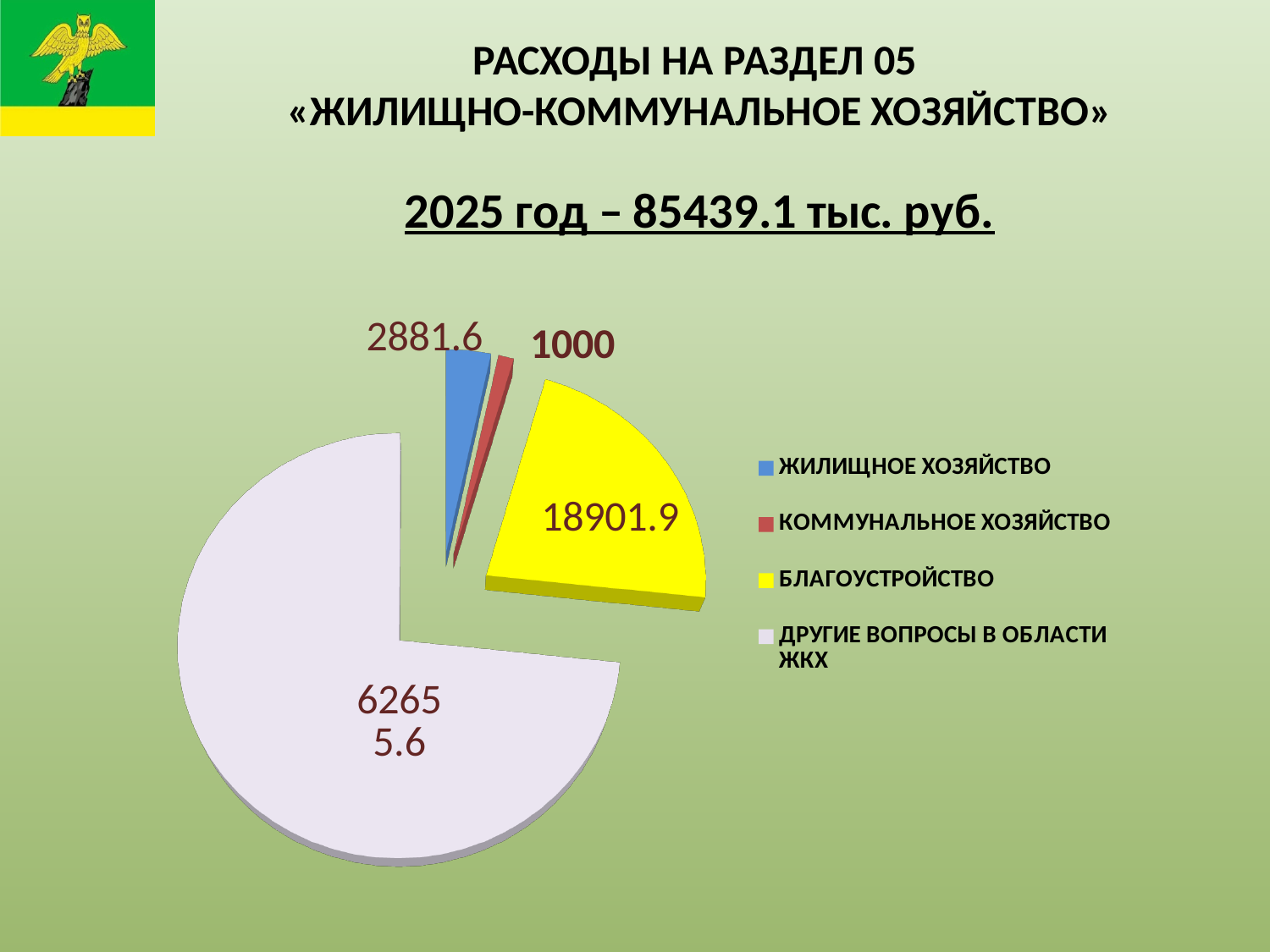
What is the value for ДРУГИЕ ВОПРОСЫ В ОБЛАСТИ ЖКХ on the pie chart? 62655.6 What kind of chart is shown on the slide? Pie chart What is the difference between the values for БЛАГОУСТРОЙСТВО and ЖИЛИЩНОЕ ХОЗЯЙСТВО? 16020.3 Which is larger, the value for ЖИЛИЩНОЕ ХОЗЯЙСТВО or the value for КОММУНАЛЬНОЕ ХОЗЯЙСТВО? ЖИЛИЩНОЕ ХОЗЯЙСТВО What is the value for КОММУНАЛЬНОЕ ХОЗЯЙСТВО on the pie chart? 1000 Which category has the smallest slice of the pie chart? КОММУНАЛЬНОЕ ХОЗЯЙСТВО What is the value for БЛАГОУСТРОЙСТВО on the pie chart? 18901.9 What is the difference between the values for ЖИЛИЩНОЕ ХОЗЯЙСТВО and КОММУНАЛЬНОЕ ХОЗЯЙСТВО? 1881.6 What colour is the slice for БЛАГОУСТРОЙСТВО? Yellow Which category has the largest slice of the pie chart? ДРУГИЕ ВОПРОСЫ В ОБЛАСТИ ЖКХ How many categories does the pie chart show? 4 What is the value for ЖИЛИЩНОЕ ХОЗЯЙСТВО on the pie chart? 2881.6